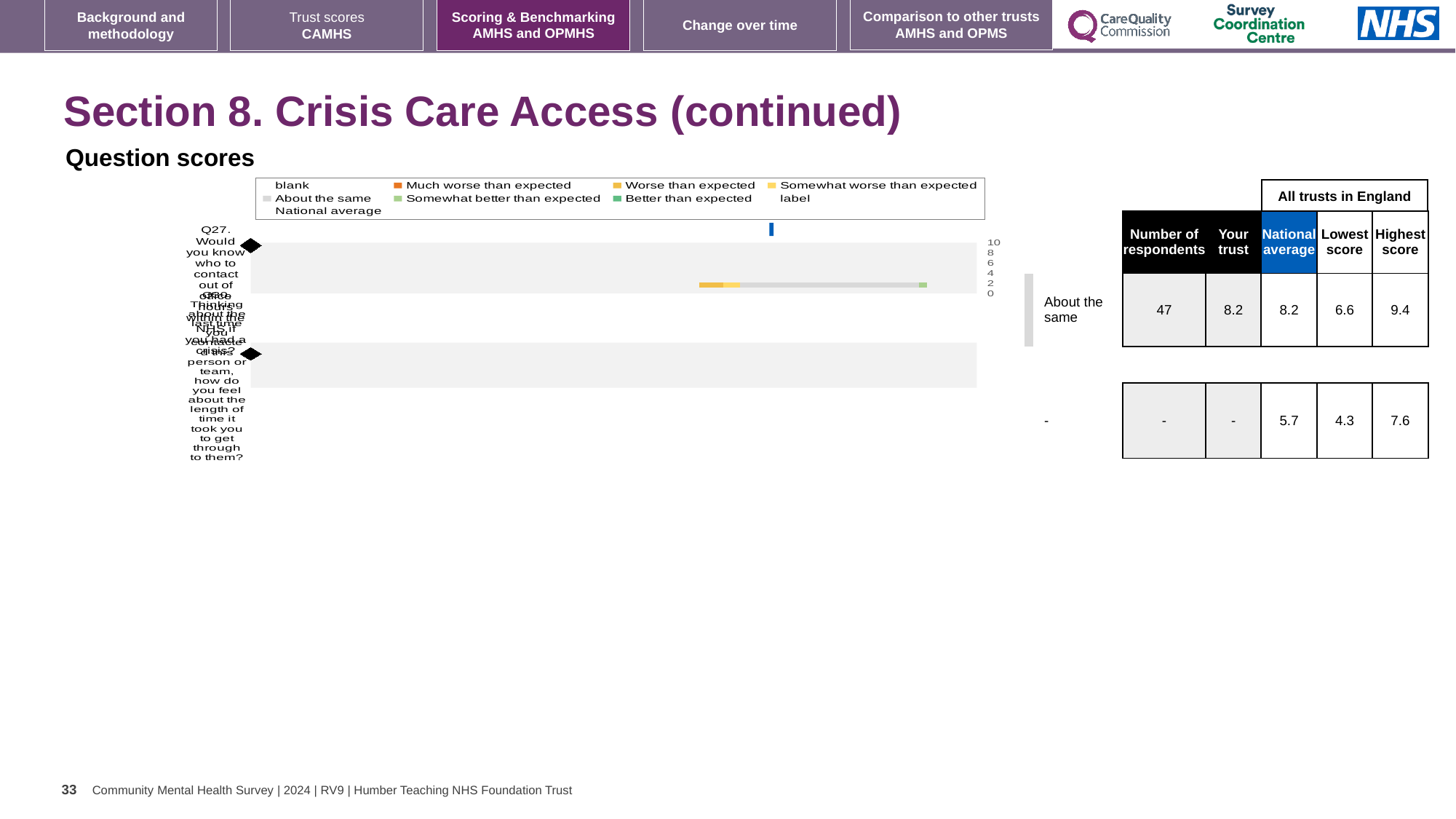
In the table next to the chart, what is the lowest score among all trusts in England for Q27? 6.6 What is the difference between the highest score (9.4) and the lowest score (6.6) for Q27 in the table? 2.8 In the table next to the chart, what is the national average for the second question (about the length of time it took to get through)? 5.7 What kind of chart is used to show the question scores on this slide? bar chart What benchmark category is shown for Q27 next to the chart? About the same In the table next to the chart, what is the 'Your trust' score for Q27? 8.2 In the table next to the chart, what is the national average for Q27? 8.2 What is the highest tick value shown on the chart's score axis? 10 Which question has the higher national average in the table: Q27 (8.2) or the second question (5.7)? Q27 In the table next to the chart, what is the highest score among all trusts in England for Q27? 9.4 What is the heading above the question scores chart? Question scores In the table next to the chart, how many respondents are listed for Q27 (would you know who to contact out of office hours)? 47